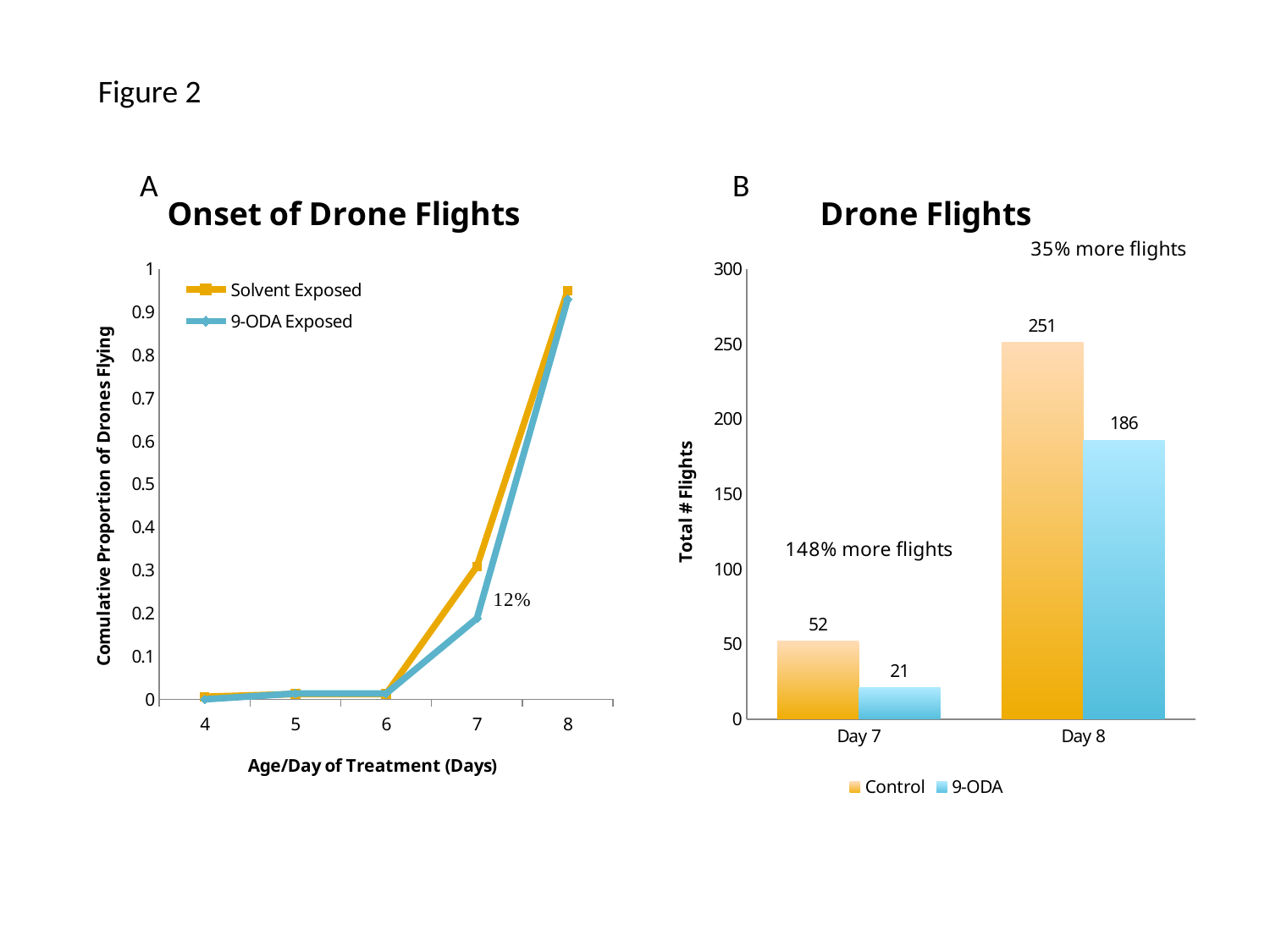
In the Onset of Drone Flights chart, is the value for Solvent Exposed at day 8 greater or less than 0.9? greater In the Drone Flights chart, what is the value for 9-ODA on Day 8? 186 What kind of chart is the Onset of Drone Flights chart? Line chart In the Drone Flights chart, which bar is the lowest? 9-ODA on Day 7 In the Drone Flights chart, how many series does the legend list? 2 In the Onset of Drone Flights chart, do the values rise or fall from day 6 to day 8? Rise In the Onset of Drone Flights chart, what is the label of the x axis? Age/Day of Treatment (Days) In the Drone Flights chart, which is larger on Day 7, Control or 9-ODA? Control In the Drone Flights chart, what is the value for Control on Day 7? 52 In the Drone Flights chart, which bar is the highest? Control on Day 8 In the Drone Flights chart, what is the value for 9-ODA on Day 7? 21 In the Drone Flights chart, what is the difference between Control and 9-ODA on Day 8? 65